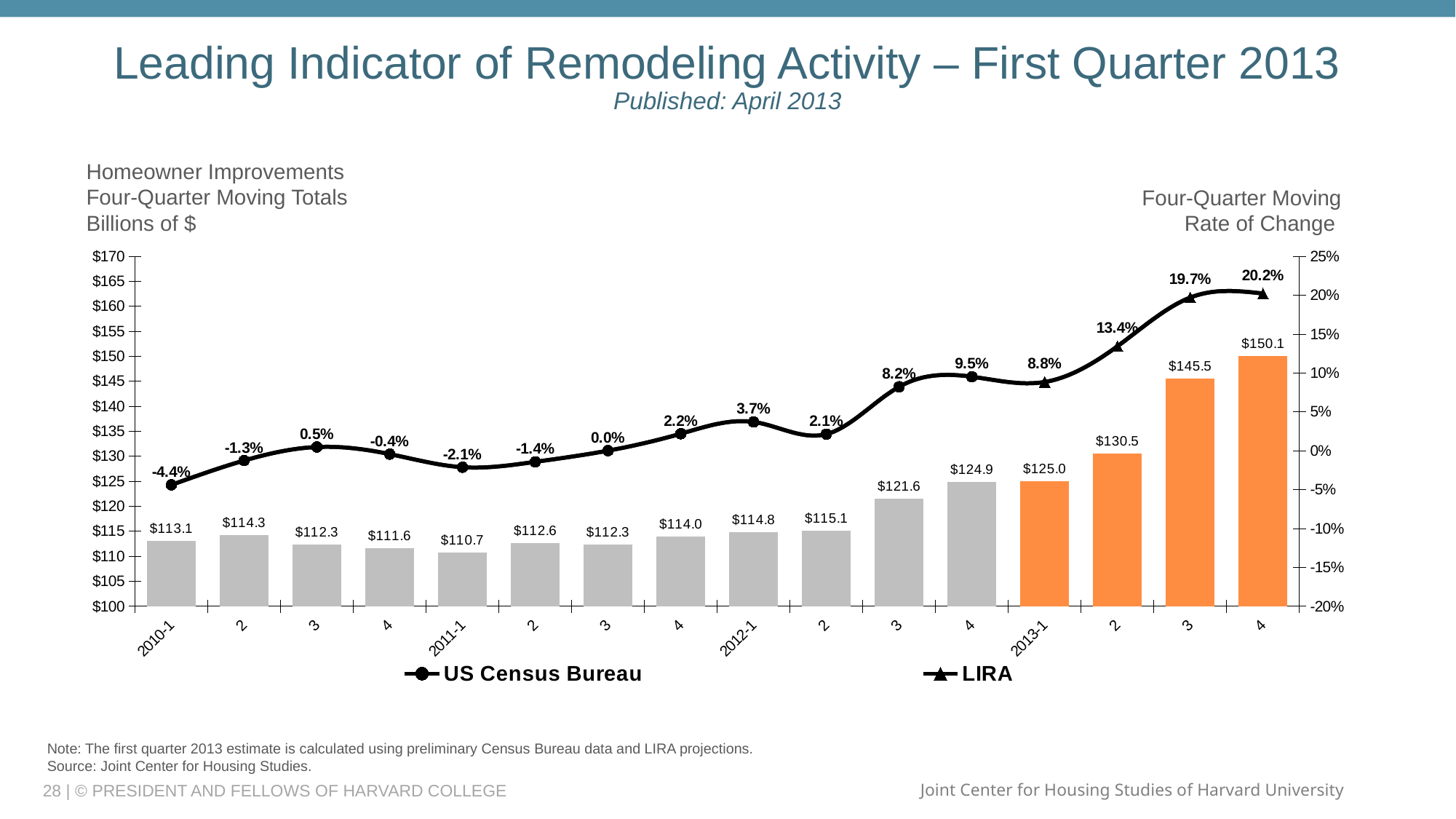
What is the four-quarter moving total for 2011-1? $110.7 How many series does the legend list? 2 What is the four-quarter moving total for 2013-1? $125.0 What kind of chart is shown on the slide? Combination bar and line chart Is the four-quarter moving total for 2012-3 greater or less than $120? greater What is the difference between the four-quarter moving totals for 2013-4 and 2013-3? $4.6 Do the four-quarter moving totals rise or fall from 2012-1 to 2013-4? rise How many quarters are plotted as bars on the chart? 16 Which quarter has the highest four-quarter moving total? 2013-4 What is the four-quarter moving rate of change for 2012-3? 8.2% Which is larger, the rate of change for 2012-4 or for 2013-1? 2012-4 Which quarter has the lowest four-quarter moving rate of change? 2010-1